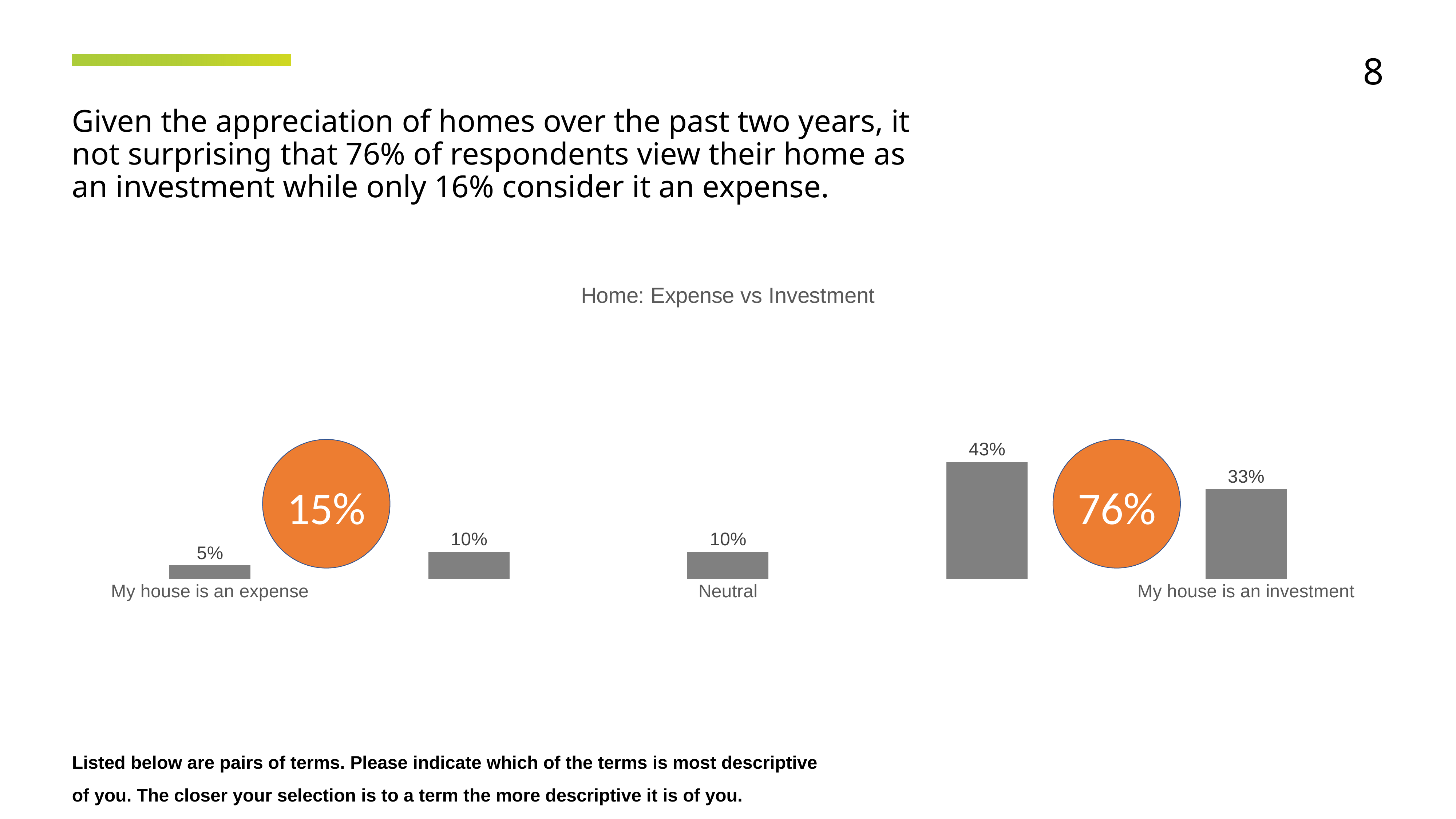
What is the difference between the values for 'My house is an investment' and 'My house is an expense'? 28% How many bars are plotted in the chart? 5 What is the value for 'My house is an investment'? 33% What percentage is shown in the orange circle on the right side of the chart? 76% Is the value for 'My house is an investment' greater or less than the value for 'Neutral'? greater What is the value for 'Neutral'? 10% What is the highest value shown by any bar in the chart? 43% What is the title of the chart? Home: Expense vs Investment What is the value for 'My house is an expense'? 5% Which is larger, the value for 'Neutral' or the value for 'My house is an expense'? Neutral Which labeled category has the lowest value? My house is an expense What kind of chart is shown on the slide? Bar chart